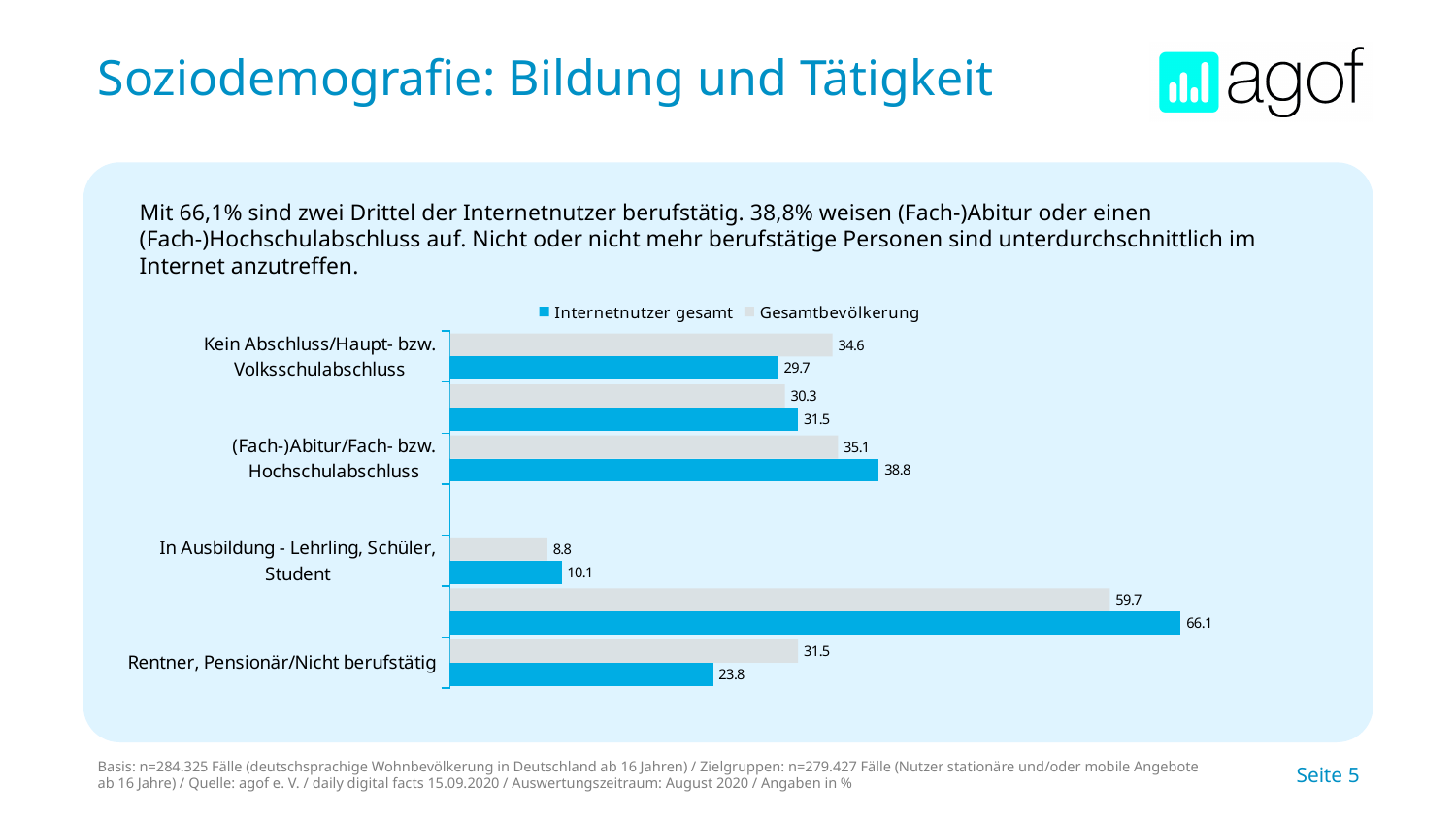
What is the difference between Gesamtbevölkerung and Internetnutzer gesamt for Rentner, Pensionär/Nicht berufstätig? 7.7 What is the highest value shown for the Internetnutzer gesamt series? 66.1 What is the difference between Internetnutzer gesamt and Gesamtbevölkerung for (Fach-)Abitur/Fach- bzw. Hochschulabschluss? 3.7 Which colour represents the Internetnutzer gesamt series in the legend? Blue For In Ausbildung - Lehrling, Schüler, Student, which series has the larger value: Internetnutzer gesamt or Gesamtbevölkerung? Internetnutzer gesamt What kind of chart is shown on the slide? Bar chart What is the value for Gesamtbevölkerung in the category In Ausbildung - Lehrling, Schüler, Student? 8.8 What is the value for Gesamtbevölkerung in the category Kein Abschluss/Haupt- bzw. Volksschulabschluss? 34.6 How many series does the legend list? 2 Which labelled category has the lowest value for Internetnutzer gesamt? In Ausbildung - Lehrling, Schüler, Student What is the value for Internetnutzer gesamt in the category (Fach-)Abitur/Fach- bzw. Hochschulabschluss? 38.8 What is the value for Internetnutzer gesamt in the category Rentner, Pensionär/Nicht berufstätig? 23.8